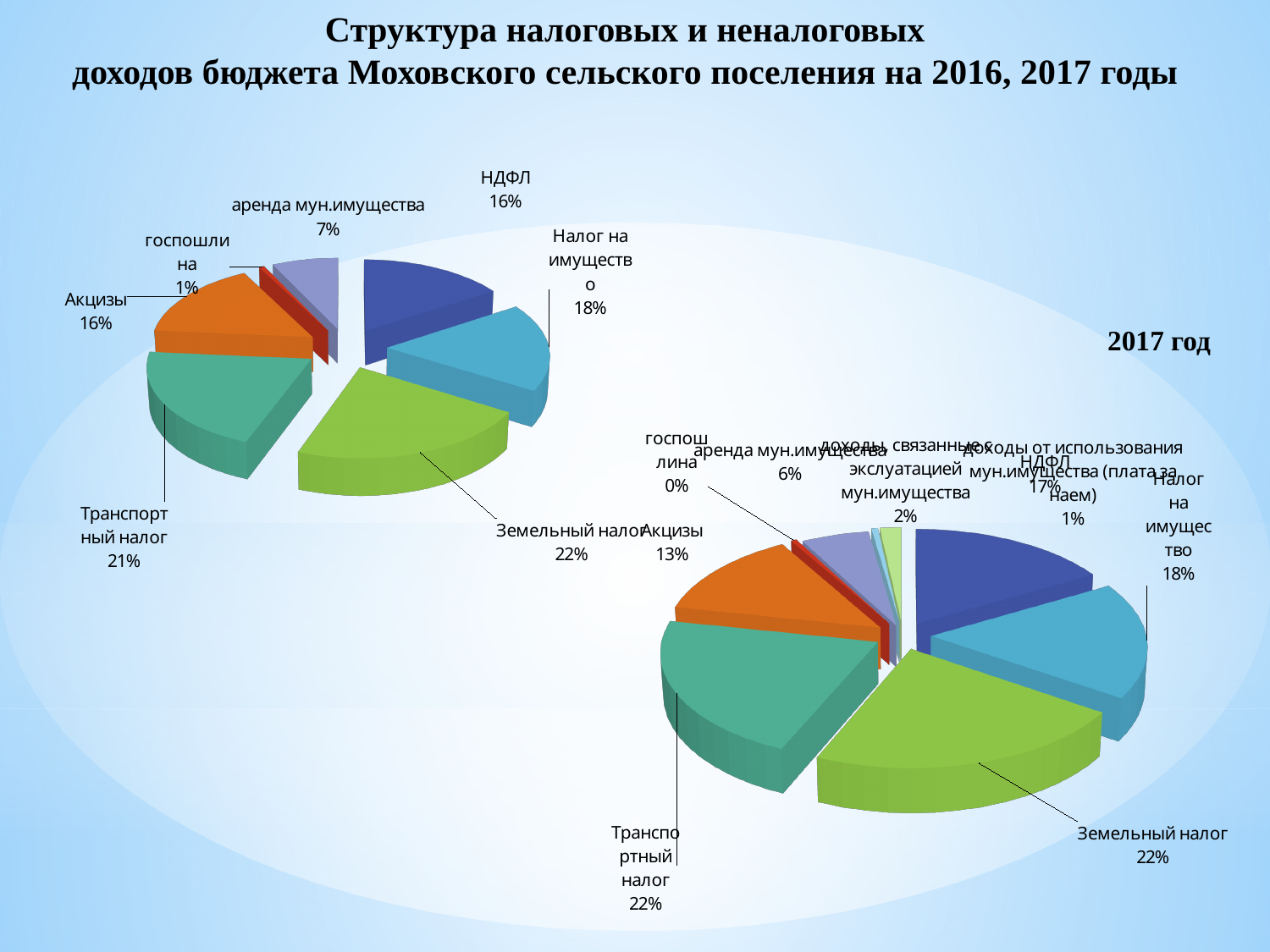
In the right pie chart (2017 год), which category has the smallest share? госпошлина Which is larger: the share of Акцизы in the left pie chart or in the right pie chart (2017 год)? Left pie chart What type of charts are shown on the slide? Pie charts In the left pie chart, what share does Земельный налог have? 22% In the left pie chart, which category has the smallest share? госпошлина Which year label is printed next to the right pie chart? 2017 год In the left pie chart, what share does Транспортный налог have? 21% In the left pie chart, which category has the largest share? Земельный налог In the right pie chart (2017 год), what share does Акцизы have? 13% In the left pie chart, what is the difference between the shares of Налог на имущество and аренда мун.имущества? 11% How many categories are shown in the left pie chart? 7 In the right pie chart (2017 год), what share does аренда мун.имущества have? 6%